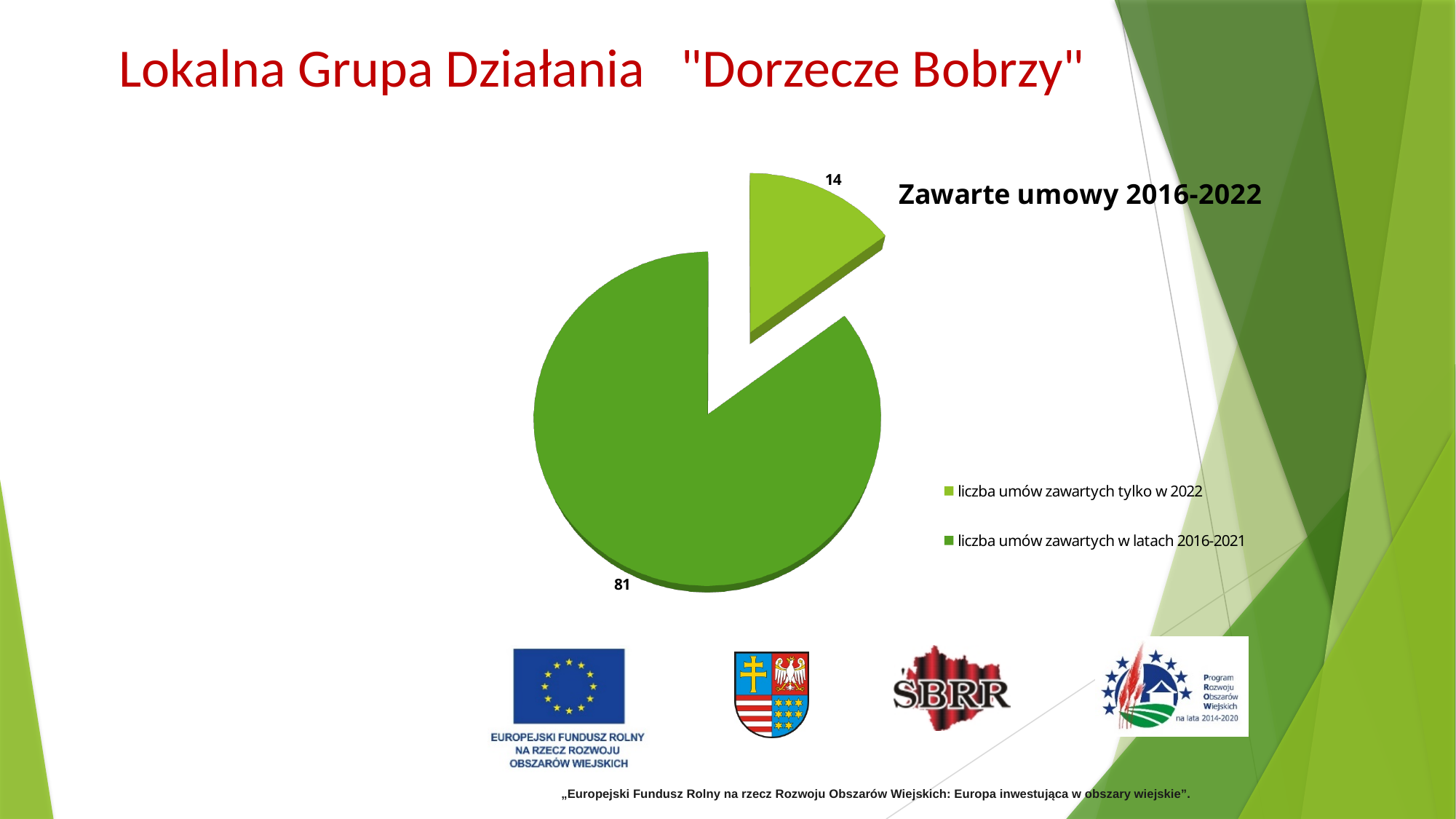
What is the difference between the number of contracts concluded in 2016-2021 and those concluded only in 2022? 67 Which slice is the largest? liczba umów zawartych w latach 2016-2021 What is the total number of contracts shown in the pie chart? 95 How many slices does the pie chart have? 2 Which slice is the smallest? liczba umów zawartych tylko w 2022 Which legend entry is shown in the lighter green colour? liczba umów zawartych tylko w 2022 What is the title of the chart? Zawarte umowy 2016-2022 How many entries does the legend list? 2 Which is larger: the number of contracts concluded only in 2022 or in 2016-2021? 2016-2021 What kind of chart is shown on the slide? pie chart What is the value for 'liczba umów zawartych tylko w 2022'? 14 What is the value for 'liczba umów zawartych w latach 2016-2021'? 81